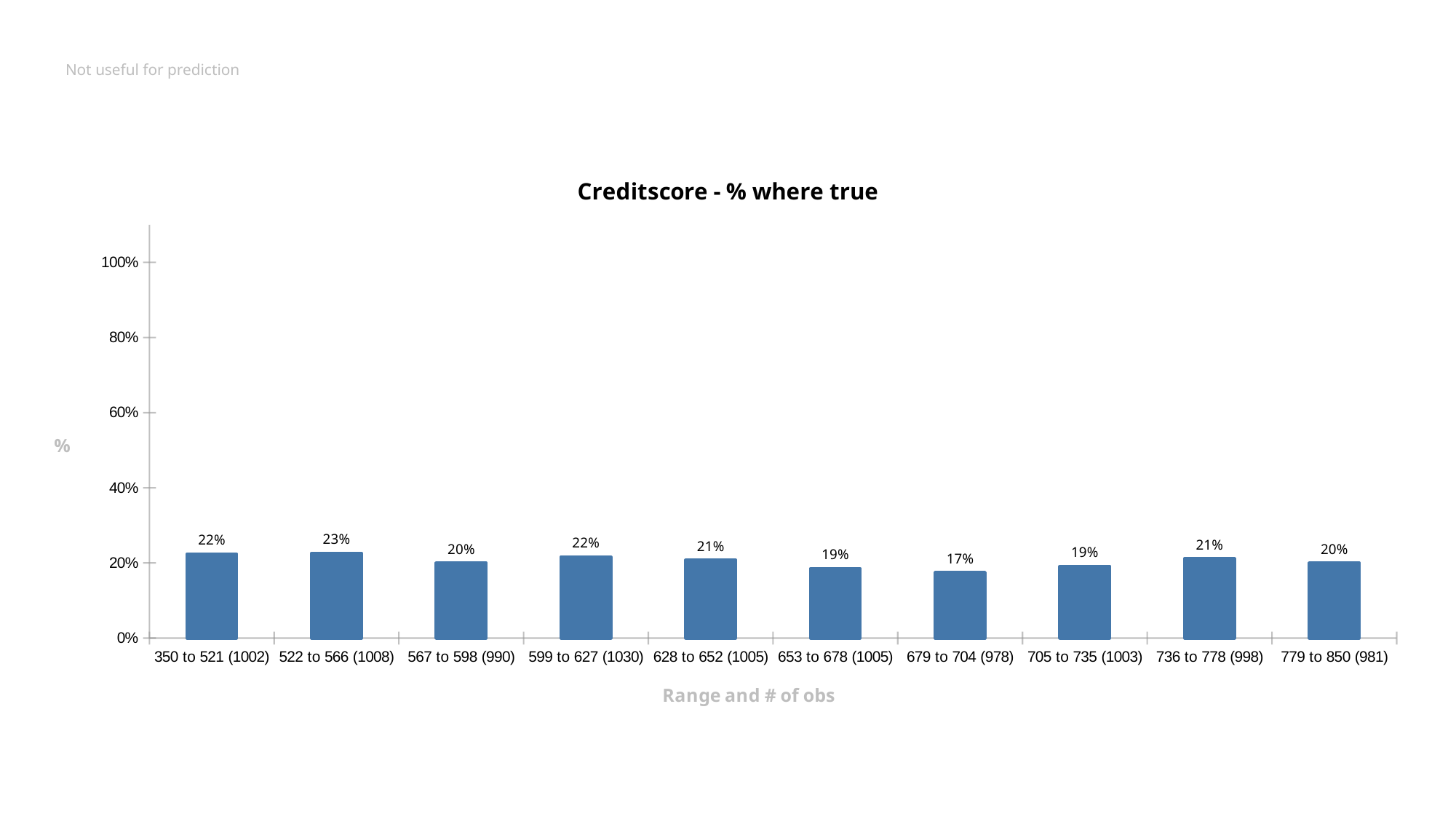
Which is larger, the value for 599 to 627 (1030) or the value for 653 to 678 (1005)? 599 to 627 (1030) Is the value for 628 to 652 (1005) greater or less than 40%? less Which range has the highest value? 522 to 566 (1008) What is the difference between the values for 522 to 566 (1008) and 679 to 704 (978)? 6% What is the value for the 350 to 521 (1002) range? 22% What is the value for the 736 to 778 (998) range? 21% Which range has the lowest value? 679 to 704 (978) How many ranges are shown on the x axis? 10 What kind of chart is this? bar chart What is the label of the x axis? Range and # of obs What is the value for the 679 to 704 (978) range? 17% What is the title of the chart? Creditscore - % where true